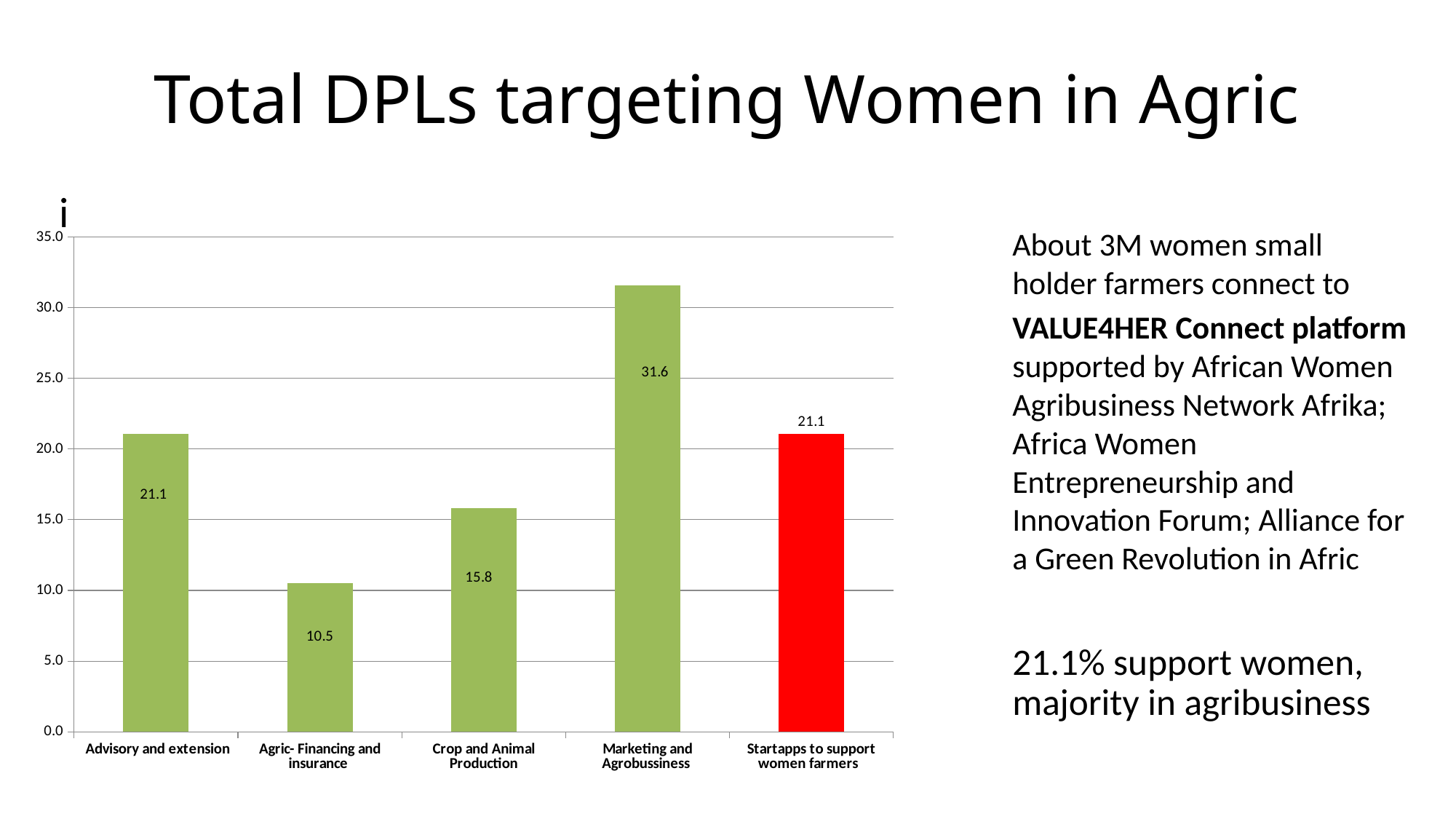
Which category has the highest value? Marketing and Agrobussiness Which bar is coloured red rather than green? Startapps to support women farmers How many categories are shown on the x axis? 5 Which category has the lowest value? Agric- Financing and insurance Which is larger, the value for Advisory and extension or the value for Crop and Animal Production? Advisory and extension What is the difference between the values for Marketing and Agrobussiness and Crop and Animal Production? 15.8 What is the value for Startapps to support women farmers? 21.1 Is the value for Marketing and Agrobussiness greater or less than 30.0? greater What is the value for Crop and Animal Production? 15.8 What is the value for Agric- Financing and insurance? 10.5 What is the value for Marketing and Agrobussiness? 31.6 What kind of chart is shown on the slide? bar chart